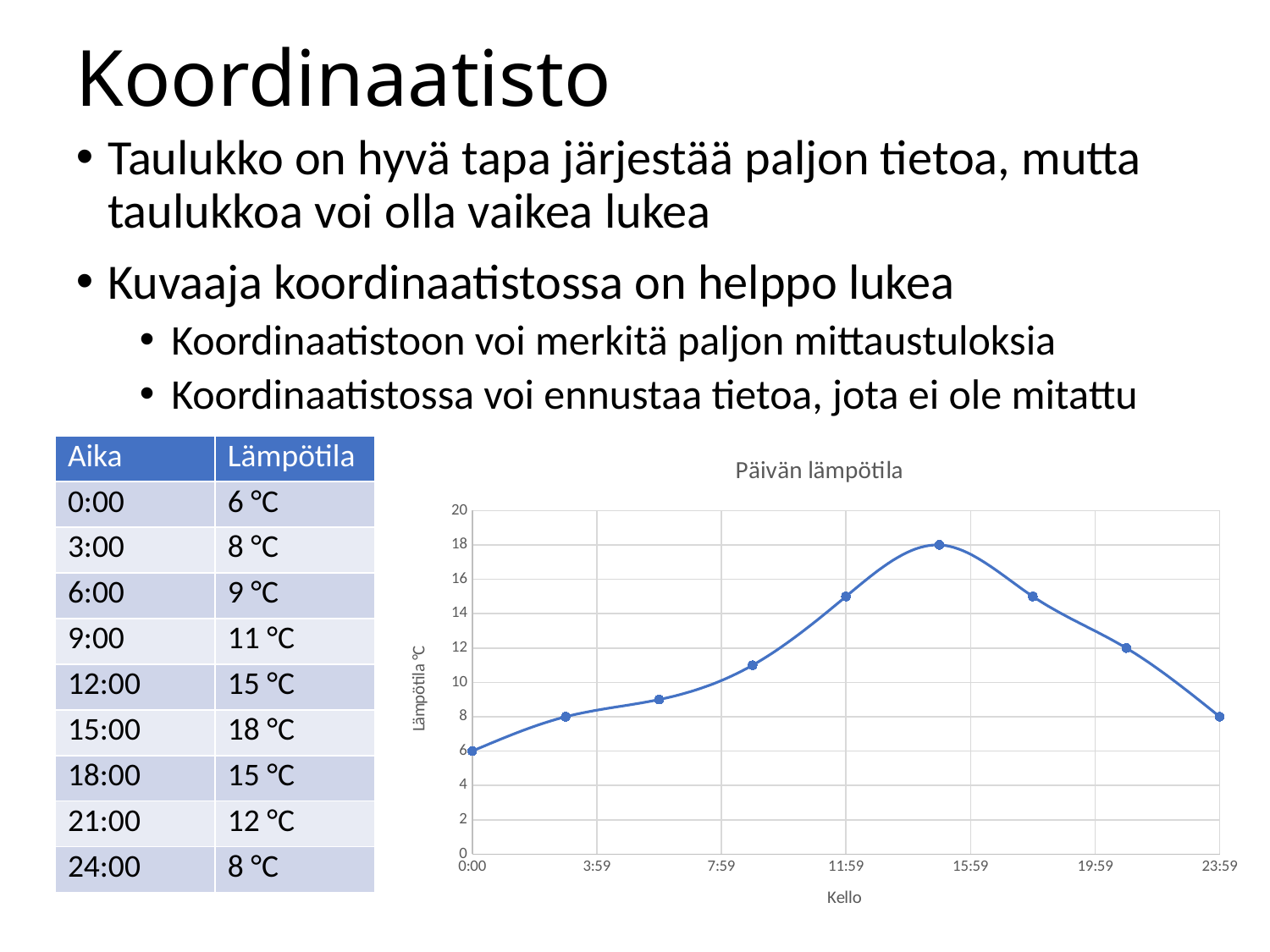
At what time does the chart reach its highest temperature? 15:00 What is the label of the vertical axis of the chart? Lämpötila °C How many data points are plotted on the line? 9 What is the temperature at 15:00 in the chart? 18 °C How much higher is the temperature at 15:00 than at 0:00? 12 °C Which time has the higher temperature, 12:00 or 21:00? 12:00 What is the temperature at 0:00 in the chart? 6 °C At what time is the temperature lowest in the chart? 0:00 What kind of chart is "Päivän lämpötila"? line chart What is the title of the chart? Päivän lämpötila What is the temperature at 21:00 in the chart? 12 °C Is the temperature at 9:00 greater or less than 10? greater